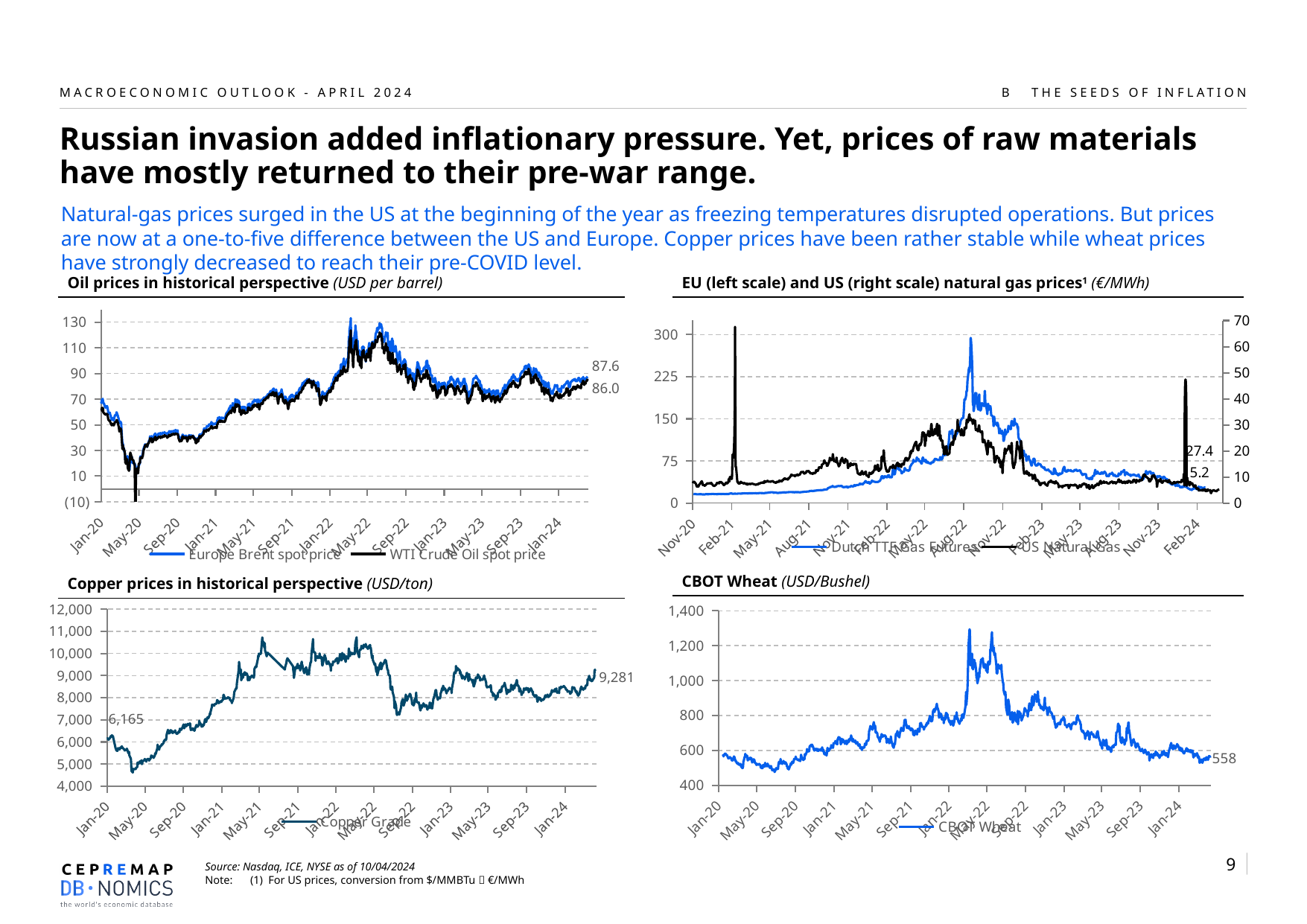
In the 'Oil prices in historical perspective' chart, what is the difference between the latest Europe Brent value and the latest WTI Crude Oil value? 1.6 In the 'EU (left scale) and US (right scale) natural gas prices' chart, what is the latest value shown for Dutch TTF Gas Futures? 27.4 In the 'CBOT Wheat' chart, is the peak value reached around mid-2022 greater or less than 1,200? greater In the 'Copper prices in historical perspective' chart, what is the difference between the latest labelled value and the starting labelled value? 3,116 In the 'CBOT Wheat' chart, what is the latest value shown? 558 In the 'Copper prices in historical perspective' chart, what is the value labelled at the start of the series in Jan-20? 6,165 What kind of chart is the 'CBOT Wheat' chart? Line chart In the 'Oil prices in historical perspective' chart, what is the latest value shown for the Europe Brent spot price? 87.6 In the 'EU (left scale) and US (right scale) natural gas prices' chart, what is the latest value shown for US Natural Gas? 5.2 In the 'Oil prices in historical perspective' chart, how many series does the legend list? 2 In the 'Copper prices in historical perspective' chart, what is the latest value shown for Copper Grade? 9,281 In the 'Oil prices in historical perspective' chart, what is the latest value shown for the WTI Crude Oil spot price? 86.0